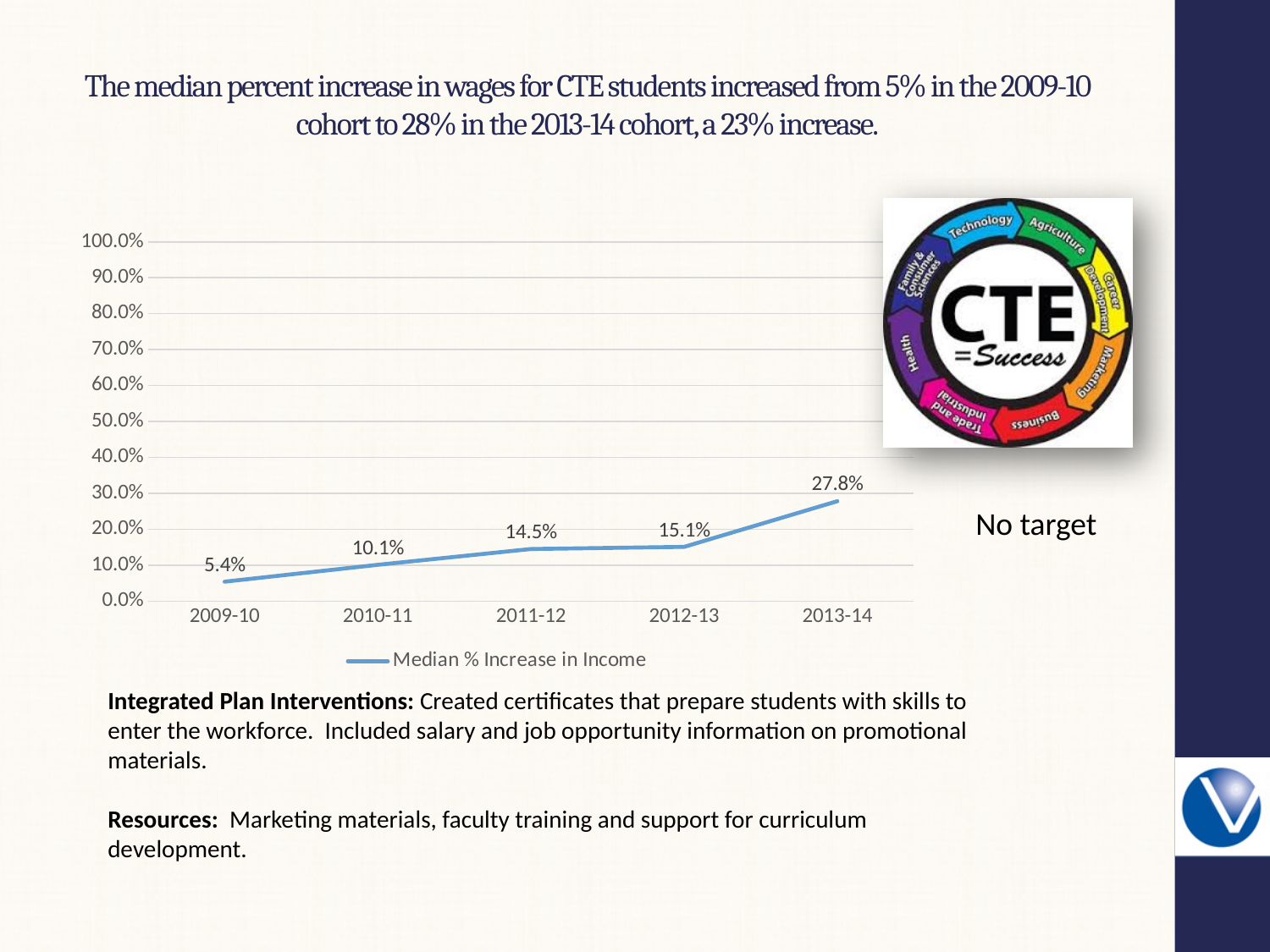
How many series does the chart legend list? 1 Which cohort has the highest Median % Increase in Income? 2013-14 What is the Median % Increase in Income for the 2009-10 cohort? 5.4% Does the Median % Increase in Income rise or fall from the 2009-10 cohort to the 2013-14 cohort? Rise What is the Median % Increase in Income for the 2011-12 cohort? 14.5% What kind of chart is shown on the slide? Line chart Which cohort has the lowest Median % Increase in Income? 2009-10 Is the Median % Increase in Income for the 2013-14 cohort greater or less than 30.0%? less What is the Median % Increase in Income for the 2013-14 cohort? 27.8% Which cohort has a larger Median % Increase in Income, 2010-11 or 2012-13? 2012-13 What is the difference in Median % Increase in Income between the 2013-14 and 2012-13 cohorts? 12.7% How many cohorts are plotted on the x axis of the chart? 5